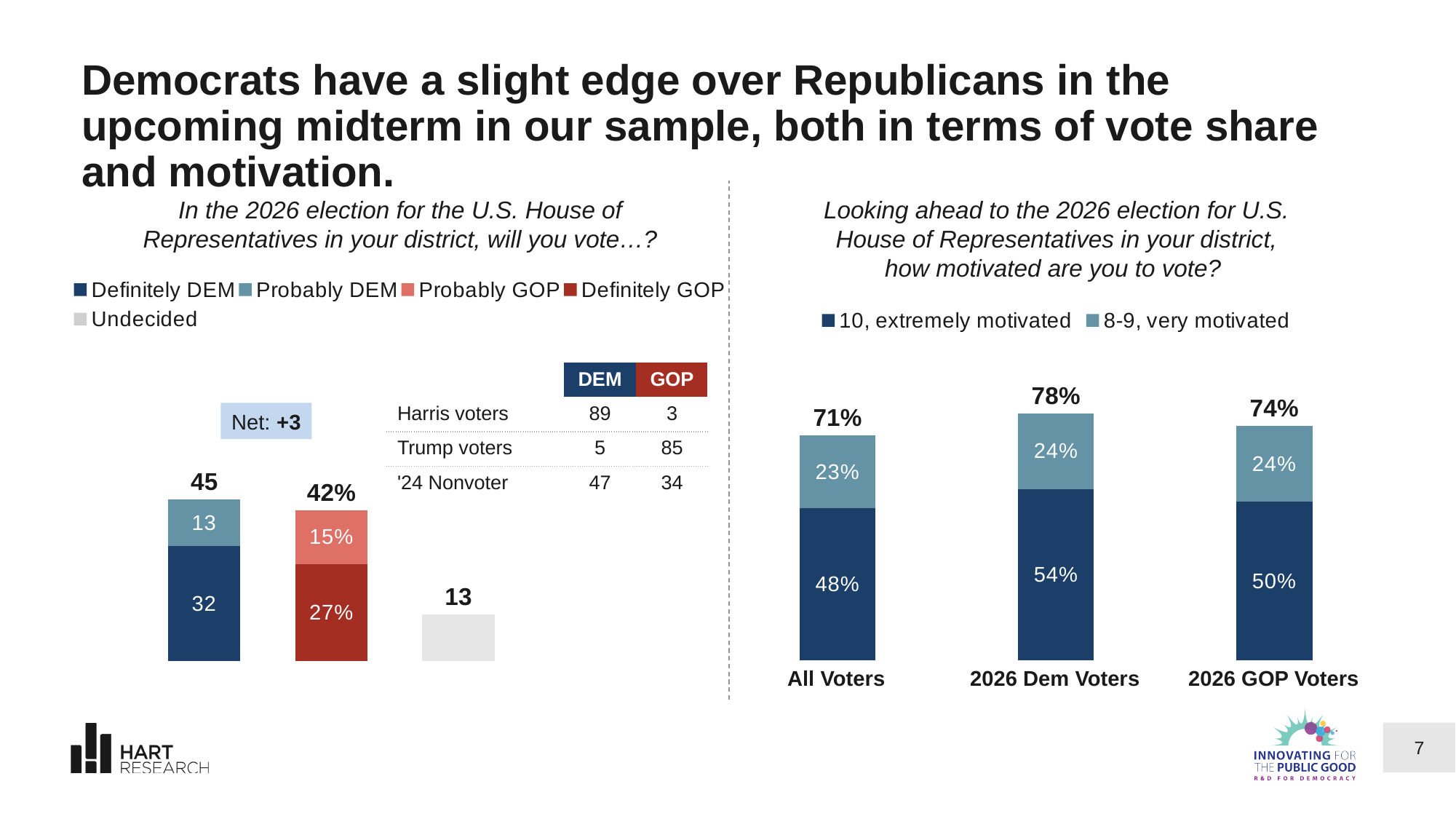
In the right chart on motivation to vote, which group has the highest combined total? 2026 Dem Voters In the left chart on 2026 House vote intention, what is the difference between the DEM total (45) and the GOP total (42%)? 3 In the right chart on motivation to vote, what share of 2026 Dem Voters are 10, extremely motivated? 54% In the left chart on 2026 House vote intention, what is the value for Probably GOP? 15% In the right chart on motivation to vote, which is larger: the 10, extremely motivated share for 2026 GOP Voters or for All Voters? 2026 GOP Voters In the left chart on 2026 House vote intention, what is the value for Undecided? 13 In the left chart on 2026 House vote intention, how many entries does the legend list? 5 In the left chart on 2026 House vote intention, what is the value for Definitely DEM? 32 In the right chart on motivation to vote, what is the combined total for All Voters? 71% In the right chart on motivation to vote, how many voter groups are shown on the x axis? 3 What kind of chart is the right chart on motivation to vote? Stacked bar chart In the left chart on 2026 House vote intention, what is the total for the GOP stacked bar? 42%